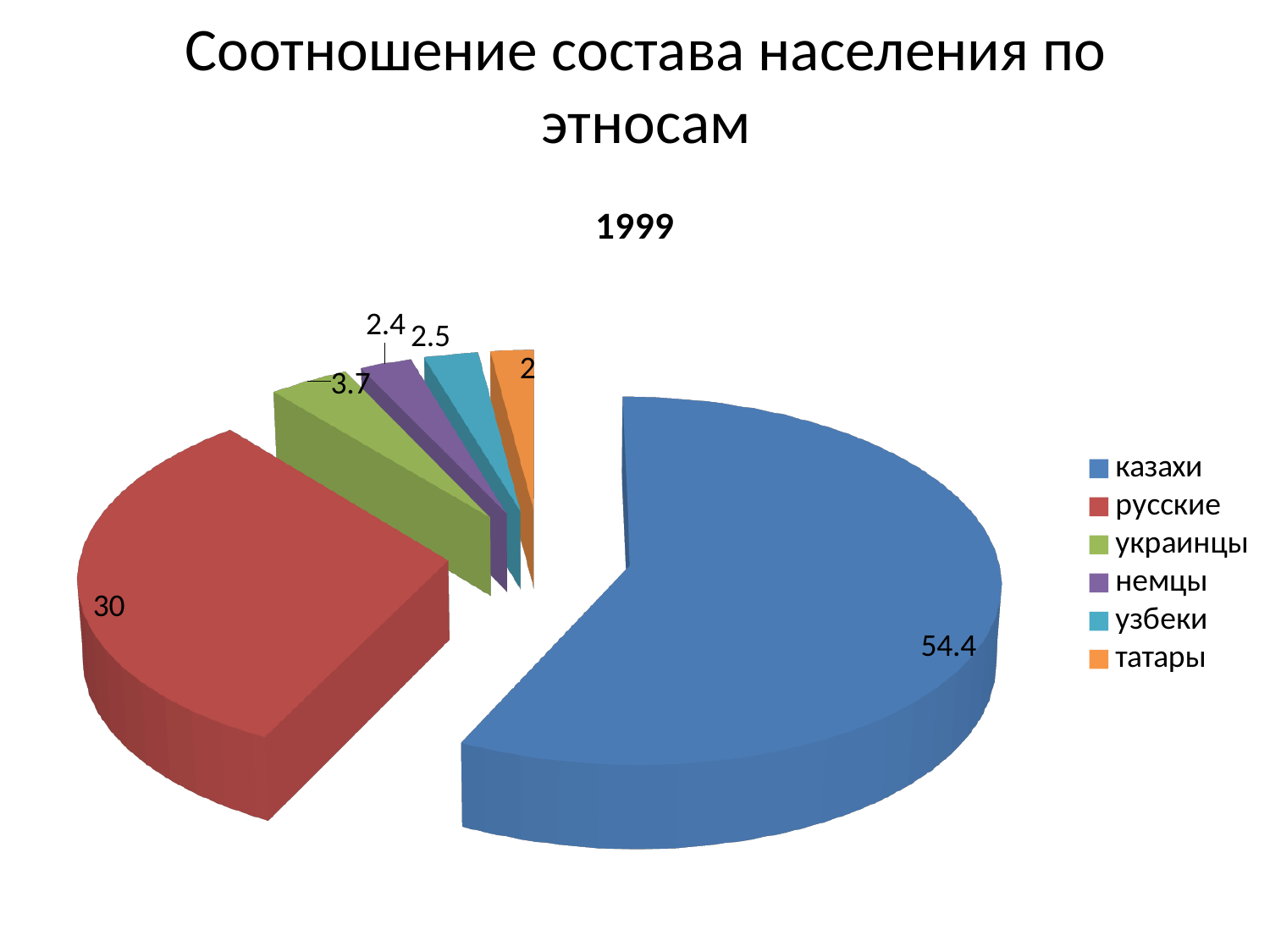
What is the value shown for украинцы? 3.7 Which is larger, the value for украинцы or the value for татары? украинцы Which ethnic group has the largest slice of the pie? казахи What is the value shown for немцы? 2.4 How many ethnic groups are listed in the legend? 6 What is the value shown for казахи? 54.4 Which ethnic group has the smallest slice of the pie? татары What is the difference between the values for казахи and русские? 24.4 What type of chart is shown on the slide? pie chart What is the value shown for русские? 30 What year is shown as the chart title? 1999 What is the value shown for узбеки? 2.5